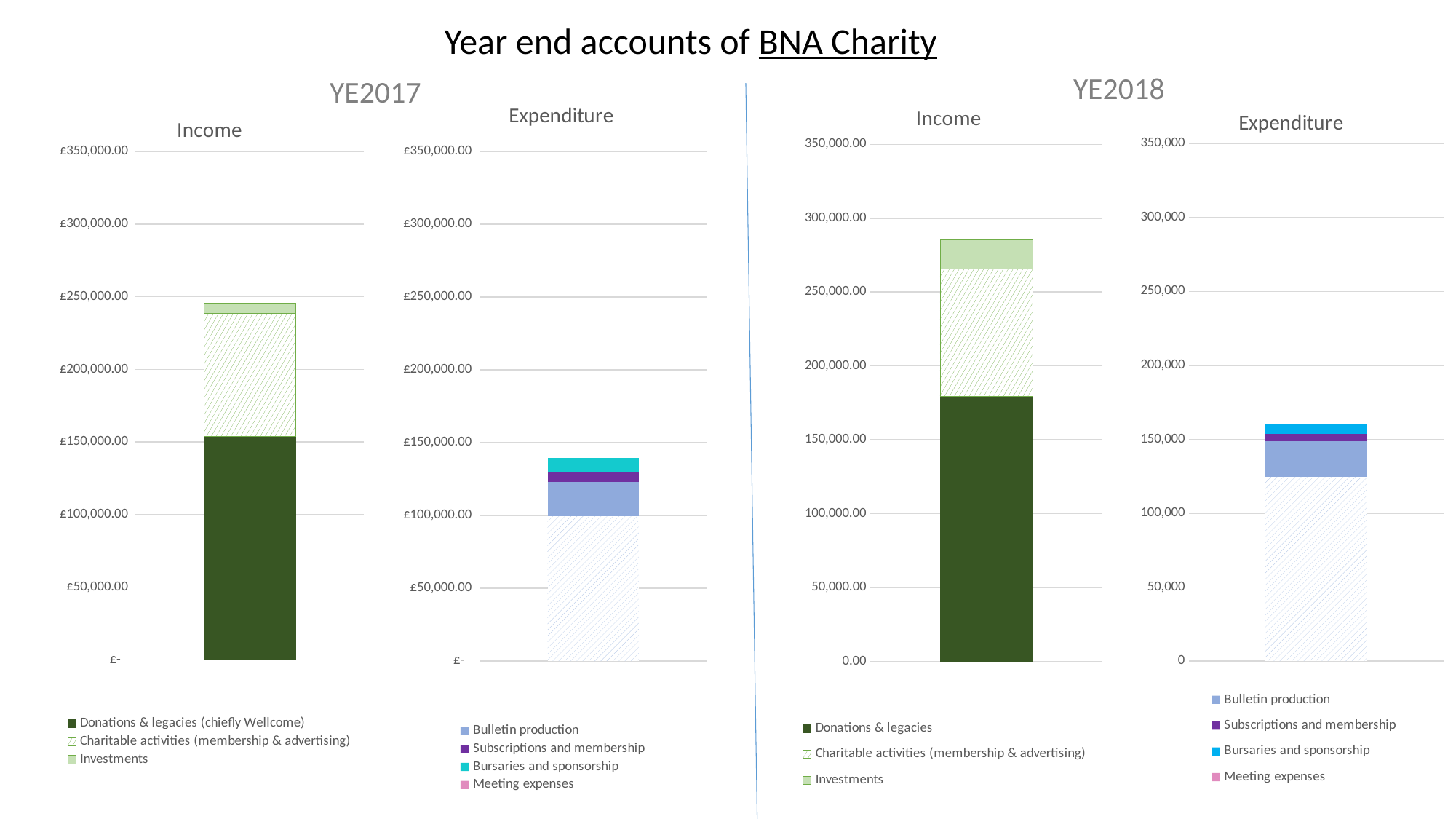
In the YE2018 Expenditure chart, is the total height of the stacked bar greater or less than 200,000? less Which is larger: the total income bar in the YE2017 Income chart or the total income bar in the YE2018 Income chart? YE2018 Income What kind of chart is the YE2017 Income chart? bar chart How many series does the legend of the YE2017 Expenditure chart list? 4 In the YE2017 Income chart, is the total height of the stacked bar greater or less than £200,000.00? greater In the YE2018 Income chart, is the total height of the stacked bar greater or less than 250,000.00? greater For YE2018, which stacked bar is taller: the Income bar or the Expenditure bar? Income How many series does the legend of the YE2017 Income chart list? 3 In the YE2017 Income chart, which legend entry is shown in dark green? Donations & legacies (chiefly Wellcome)